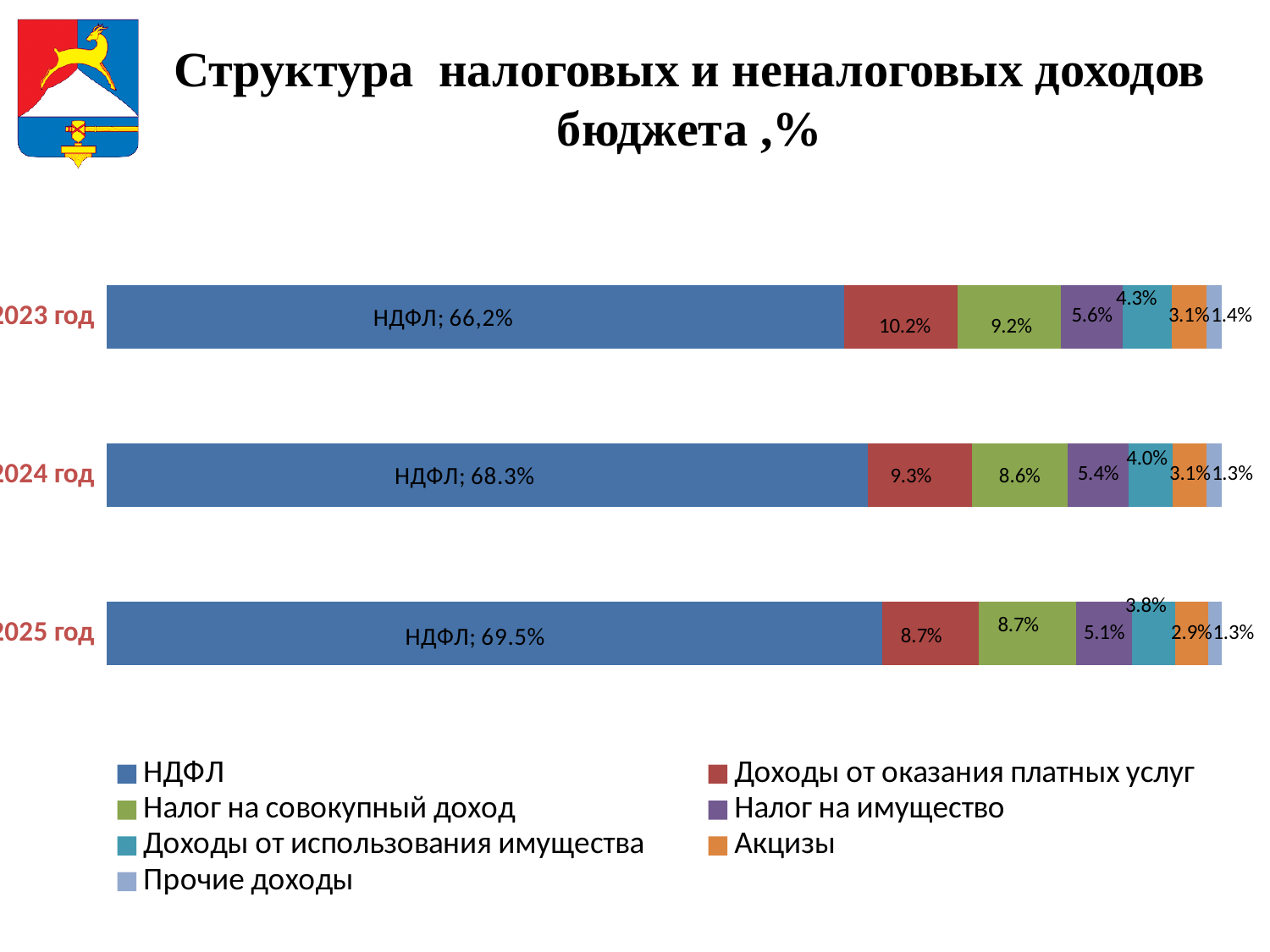
How many years (categories) are shown on the chart? 3 What is the share of НДФЛ in 2025 год? 69.5% Does the share of НДФЛ rise or fall from 2023 год to 2025 год? Rise In which year is the share of НДФЛ the highest? 2025 год What is the value for Доходы от оказания платных услуг in 2024 год? 9.3% In which year is the share of Доходы от оказания платных услуг the lowest? 2025 год How many series does the legend list? 7 What is the difference between the НДФЛ share in 2025 год and in 2024 год? 1.2% What is the value for Акцизы in 2025 год? 2.9% What type of chart is shown on the slide? Stacked bar chart Which is larger in 2023 год: Налог на имущество or Доходы от использования имущества? Налог на имущество What is the share of НДФЛ in 2023 год? 66,2%